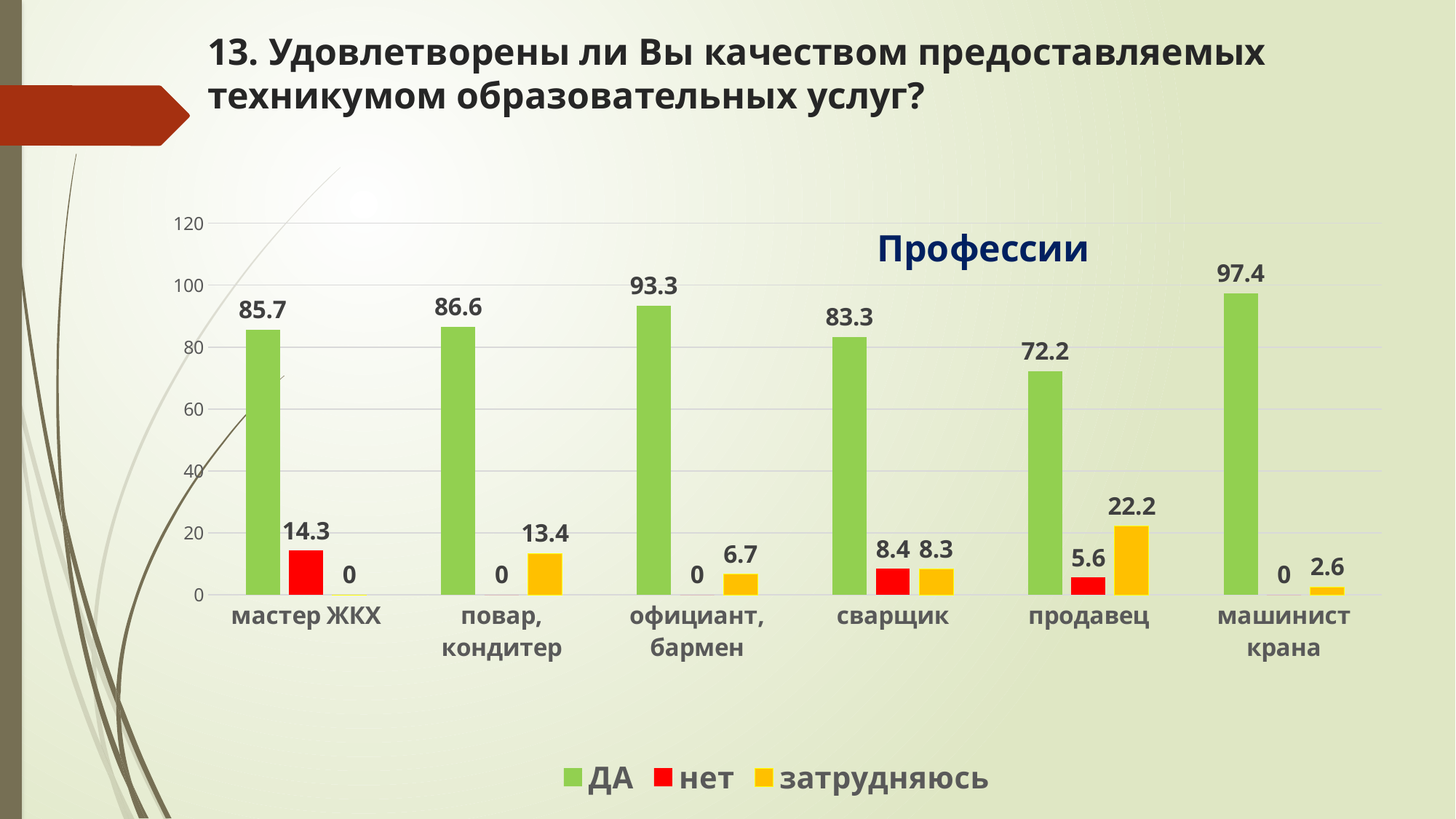
What is the value of ДА for машинист крана? 97.4 What is the value of затрудняюсь for продавец? 22.2 How many professions are shown on the x axis? 6 What is the difference between the ДА values for машинист крана and продавец? 25.2 Which profession has the highest ДА value? машинист крана What kind of chart is shown on the slide? bar chart Which profession has the lowest ДА value? продавец Which is larger for сварщик: the нет value or the затрудняюсь value? нет How many series does the legend list? 3 What is the value of нет for мастер ЖКХ? 14.3 Is the ДА value for официант, бармен greater or less than 80? greater What colour represents the ДА series? green